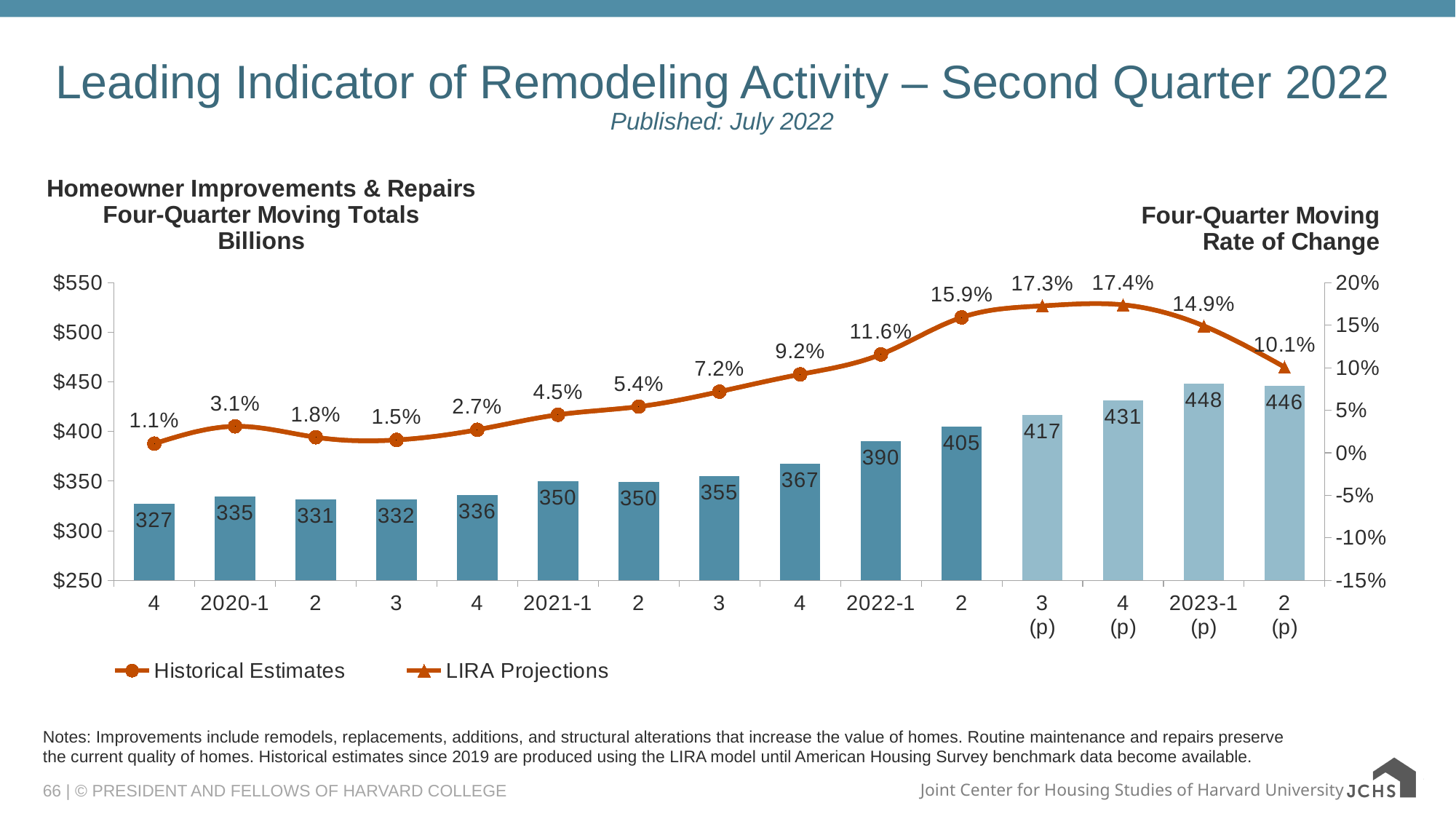
Is the four-quarter moving total for quarter 4 of 2021 greater or less than $350? greater Do the four-quarter moving totals generally rise or fall from 2021-1 to 2023-1 (p)? rise Which period has the highest four-quarter moving rate of change? 4 (p) (2022) Which is larger, the rate of change for 2020-1 or for quarter 2 of 2020? 2020-1 How many periods are shown on the x axis? 15 What is the difference between the four-quarter moving totals for 2023-1 (p) and 2022-1? 58 How many series does the legend list? 2 Which period has the lowest four-quarter moving total? 4 (2019) What is the projected four-quarter moving total for 2023-1 (p)? 448 What is the four-quarter moving rate of change for the second quarter of 2022? 15.9% What is the four-quarter moving total (in billions) for 2022-1? 390 What kind of chart is this? Combined bar and line chart